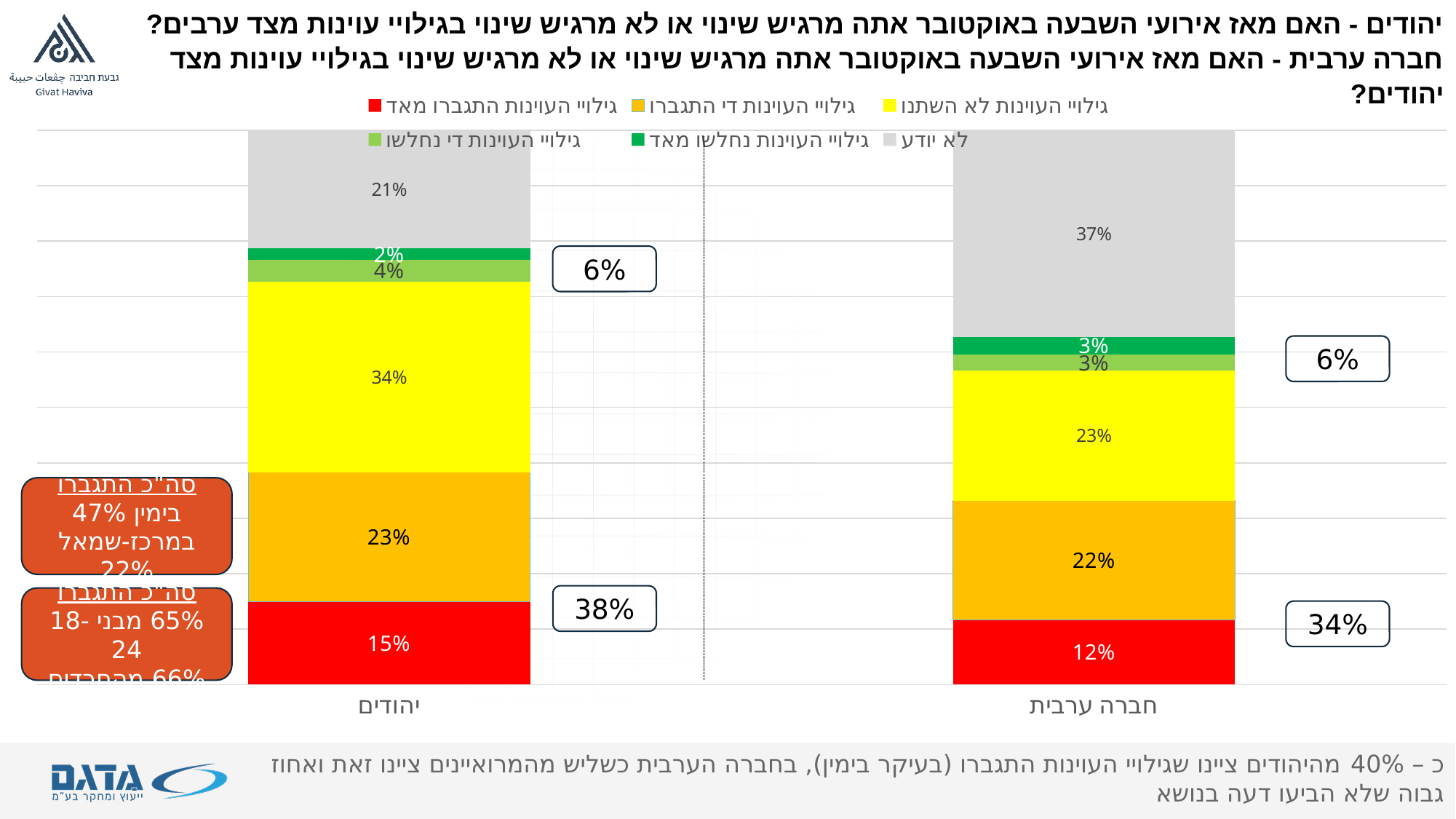
Which segment is the largest in the יהודים bar? גילויי העוינות לא השתנו (34%) What colour represents the series לא יודע in the legend? Grey How many series does the legend list? 6 What is the value of the orange segment (גילויי העוינות די התגברו) for חברה ערבית? 22% What kind of chart is shown on the slide? Stacked bar chart How many categories (bars) are plotted on the x axis? 2 What is the value of the red segment (גילויי העוינות התגברו מאד) for יהודים? 15% Which segment is the smallest in the יהודים bar? גילויי העוינות נחלשו מאד (2%) What is the value of the yellow segment (גילויי העוינות לא השתנו) for יהודים? 34% Which category has the larger grey (לא יודע) segment, יהודים or חברה ערבית? חברה ערבית What is the value of the grey segment (לא יודע) for חברה ערבית? 37% What is the difference between the yellow (לא השתנו) values for יהודים and חברה ערבית? 11%